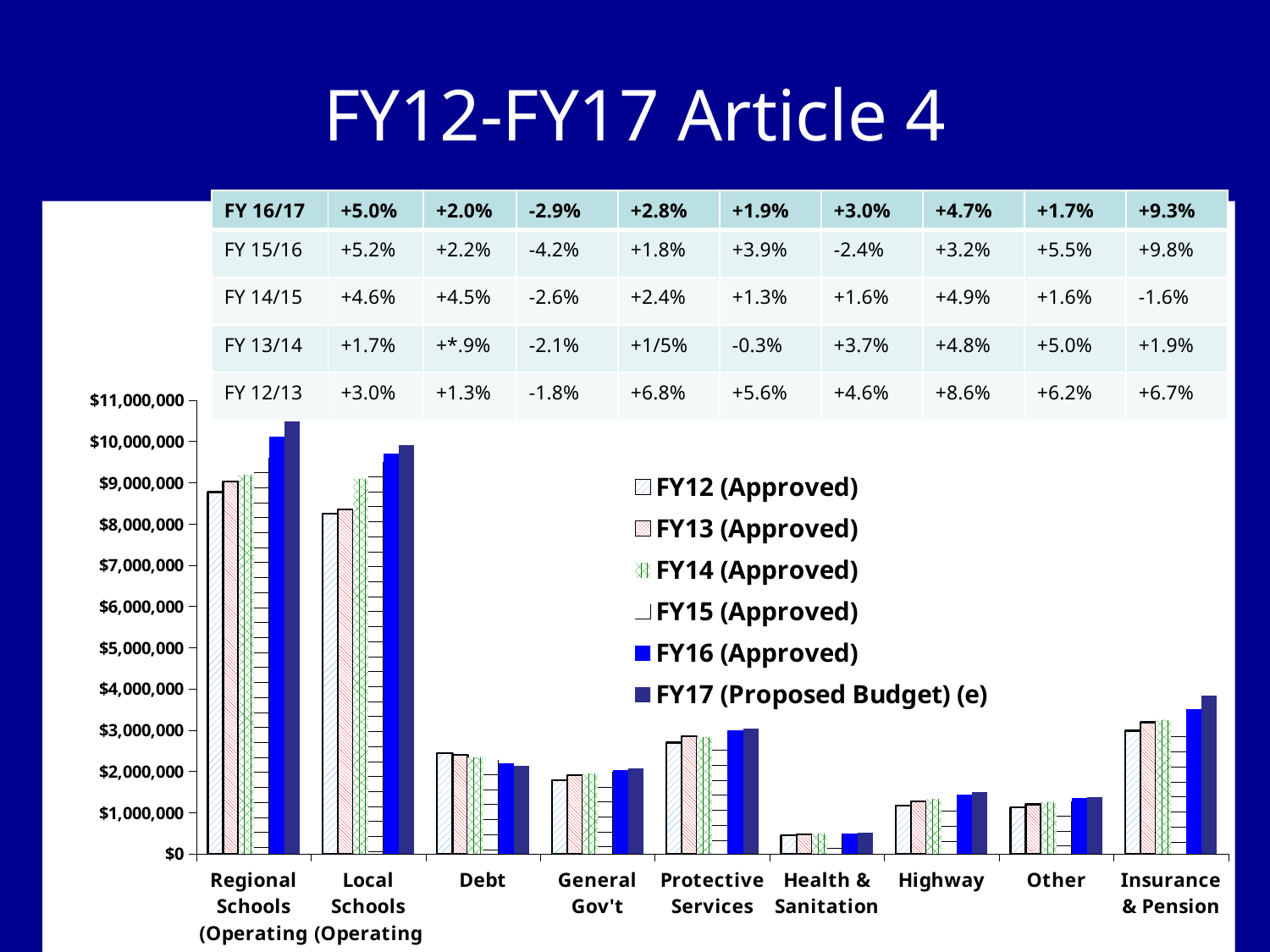
Which category has the highest bar in the chart? Regional Schools (Operating How many series does the chart's legend list? 6 Which is larger for FY17 (Proposed Budget) (e): Insurance & Pension or Protective Services? Insurance & Pension What kind of chart is shown on the slide? bar chart Do the Debt bars rise or fall from FY12 to FY17? fall What is the last entry listed in the chart's legend? FY17 (Proposed Budget) (e) How many categories are shown along the x axis of the chart? 9 Is the FY17 (Proposed Budget) (e) value for Regional Schools greater or less than $10,000,000? greater Is the FY17 (Proposed Budget) (e) value for Health & Sanitation greater or less than $1,000,000? less Is the FY12 (Approved) value for Local Schools greater or less than $9,000,000? less Which category has the lowest bars in the chart? Health & Sanitation